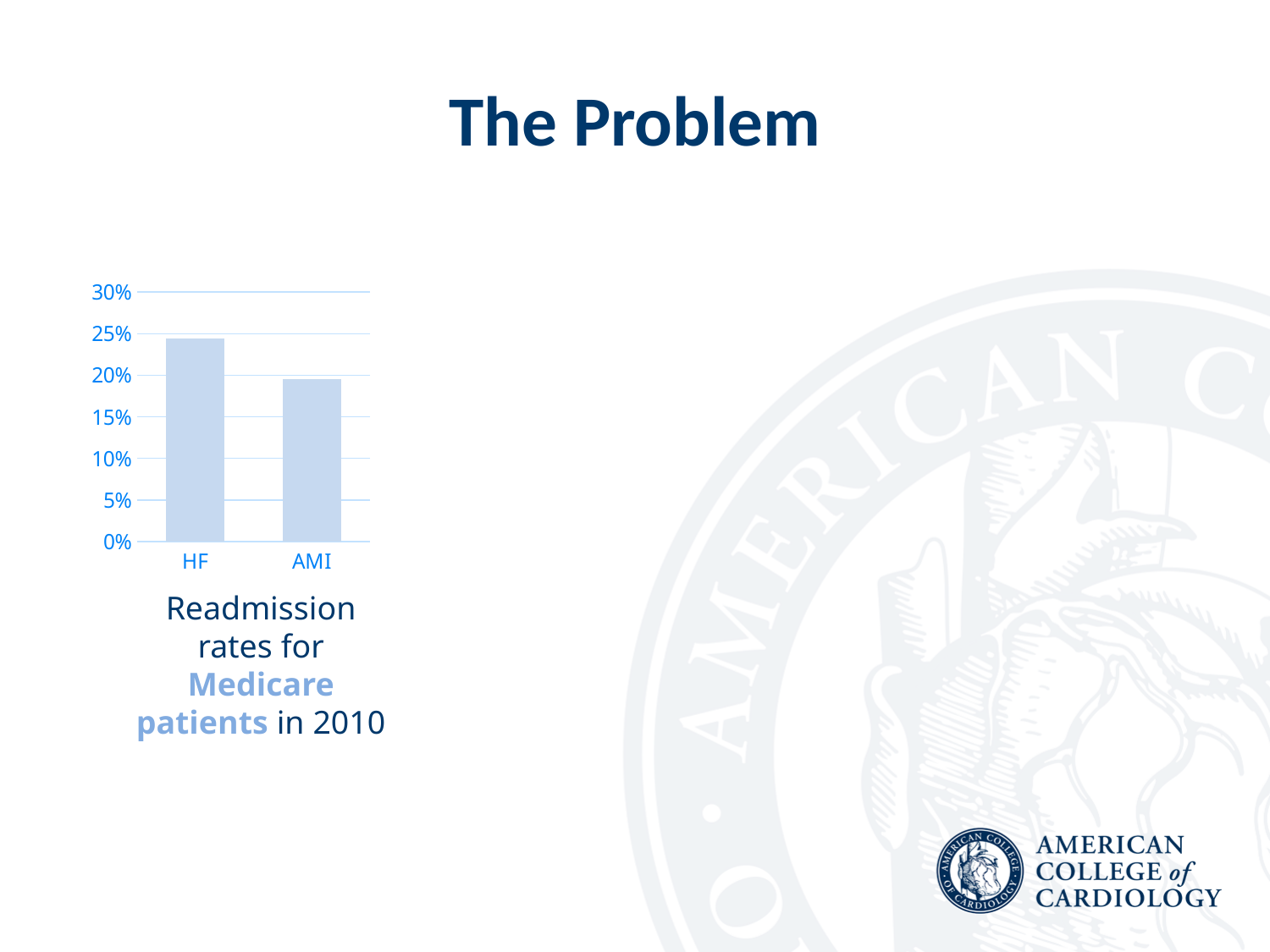
Do the values rise or fall from HF to AMI along the x axis? fall Which is larger, the value for HF or the value for AMI? HF Is the value for AMI greater or less than 15%? greater What kind of chart is shown on the slide? bar chart According to the caption below the chart, what year do the readmission rates refer to? 2010 Which category has the lowest readmission rate? AMI How many categories are plotted on the chart? 2 Is the value for HF greater or less than 20%? greater What is the highest value shown on the chart's vertical axis? 30% Which category has the highest readmission rate? HF